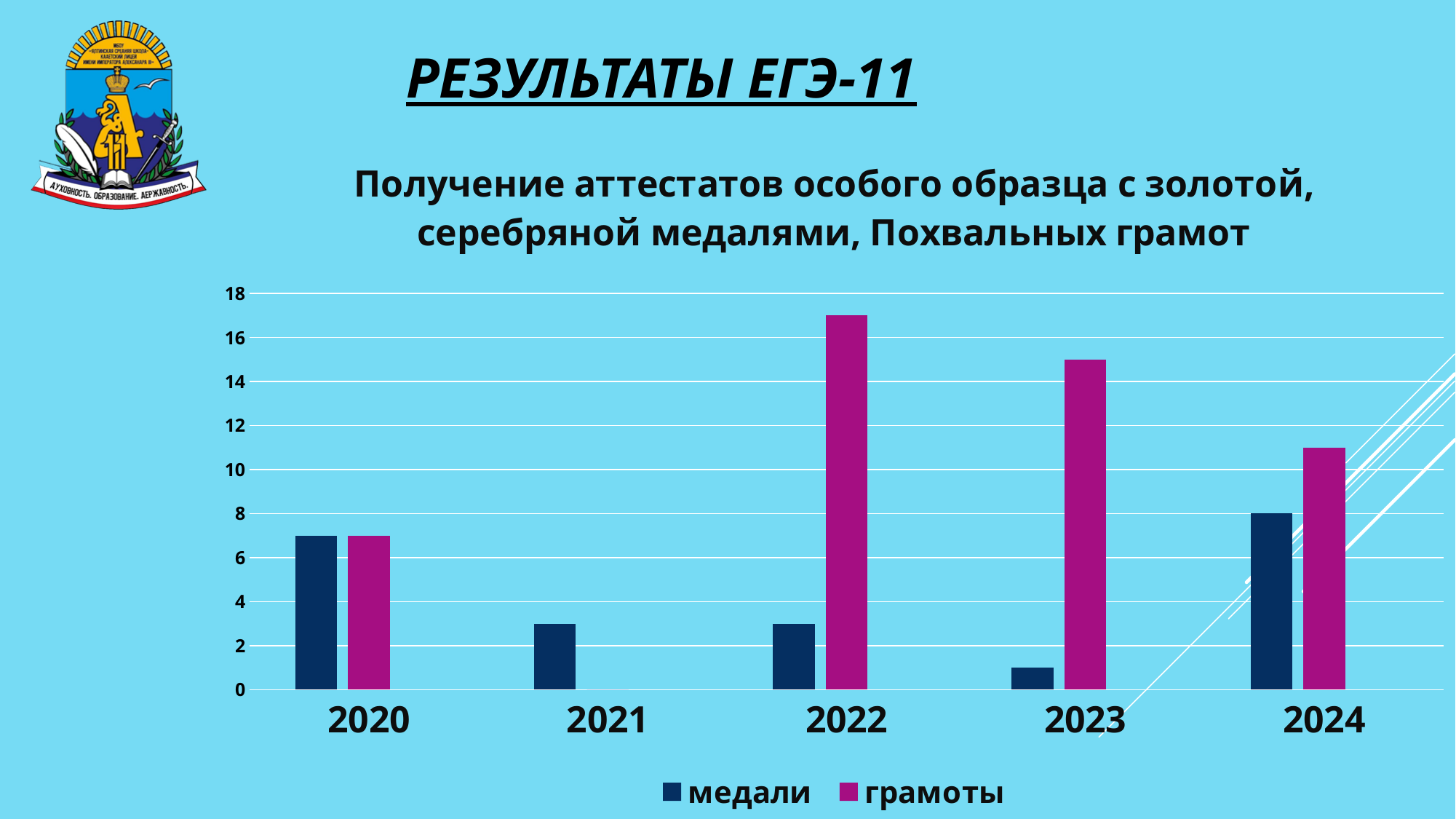
How many years are shown on the x axis? 5 Which year has the lowest value for медали? 2023 Which year has the highest value for медали? 2024 Which is larger in 2023, медали or грамоты? грамоты What kind of chart is shown on the slide? bar chart What is the value for медали in 2024? 8 Which year has the highest value for грамоты? 2022 Is the value for грамоты in 2022 greater or less than 16? greater Which series is shown in magenta in the legend? грамоты How many series does the legend list? 2 Is the value for грамоты in 2024 greater or less than 10? greater Is the value for медали in 2023 greater or less than 2? less